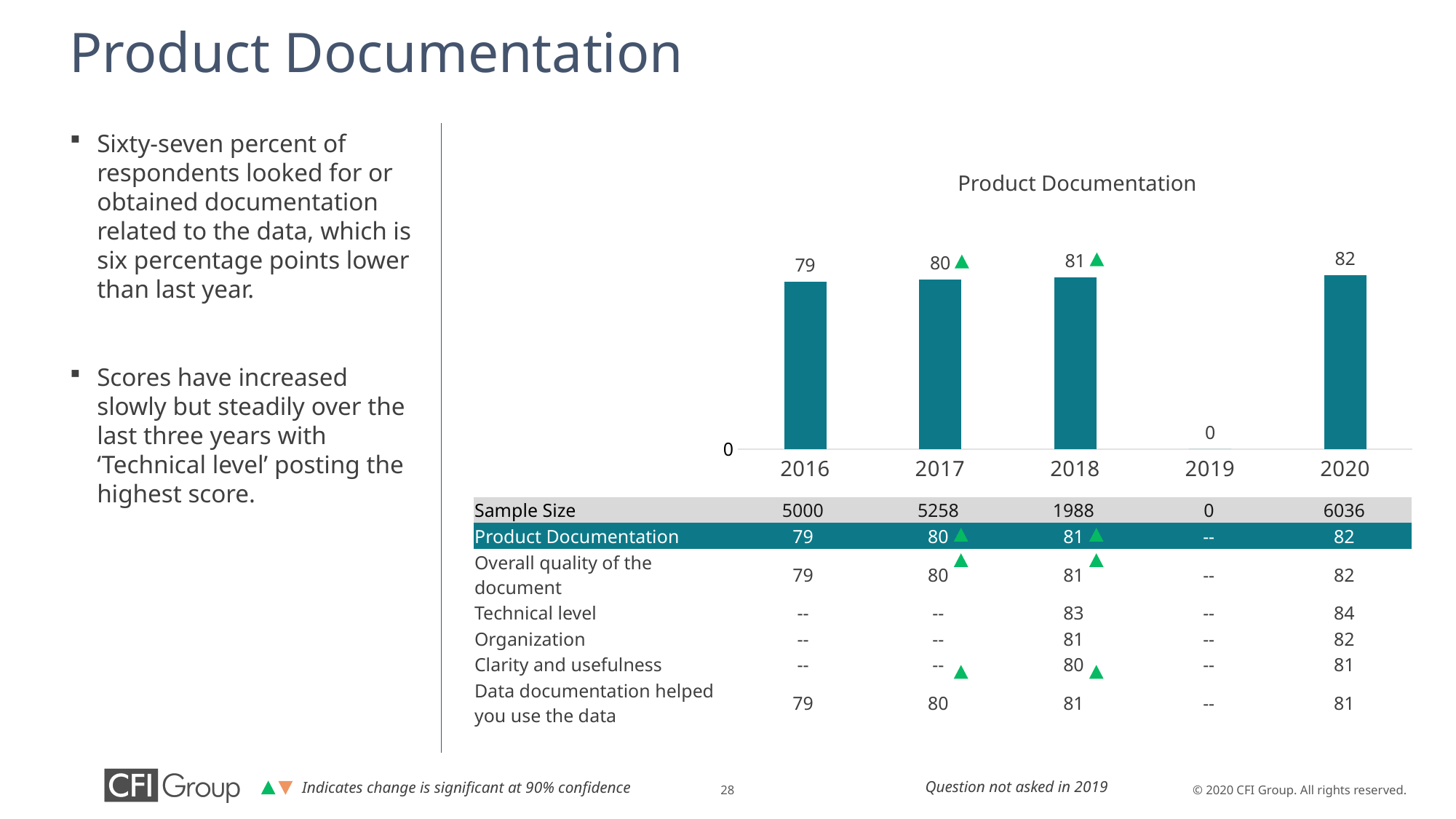
Which year has the lowest non-zero Product Documentation score? 2016 Which year has the highest Product Documentation score? 2020 What is the Product Documentation score for 2020? 82 Do the Product Documentation scores rise or fall from 2016 to 2018? rise What type of chart is shown on the slide? bar chart What value is shown for 2019 in the chart? 0 What is the difference between the 2020 and 2016 Product Documentation scores? 3 Which year has a higher Product Documentation score, 2017 or 2018? 2018 What is the Product Documentation score for 2016? 79 How many years are shown on the x axis of the chart? 5 Which years in the chart are marked with a green triangle indicating a significant change? 2017 and 2018 What is the title of the chart? Product Documentation